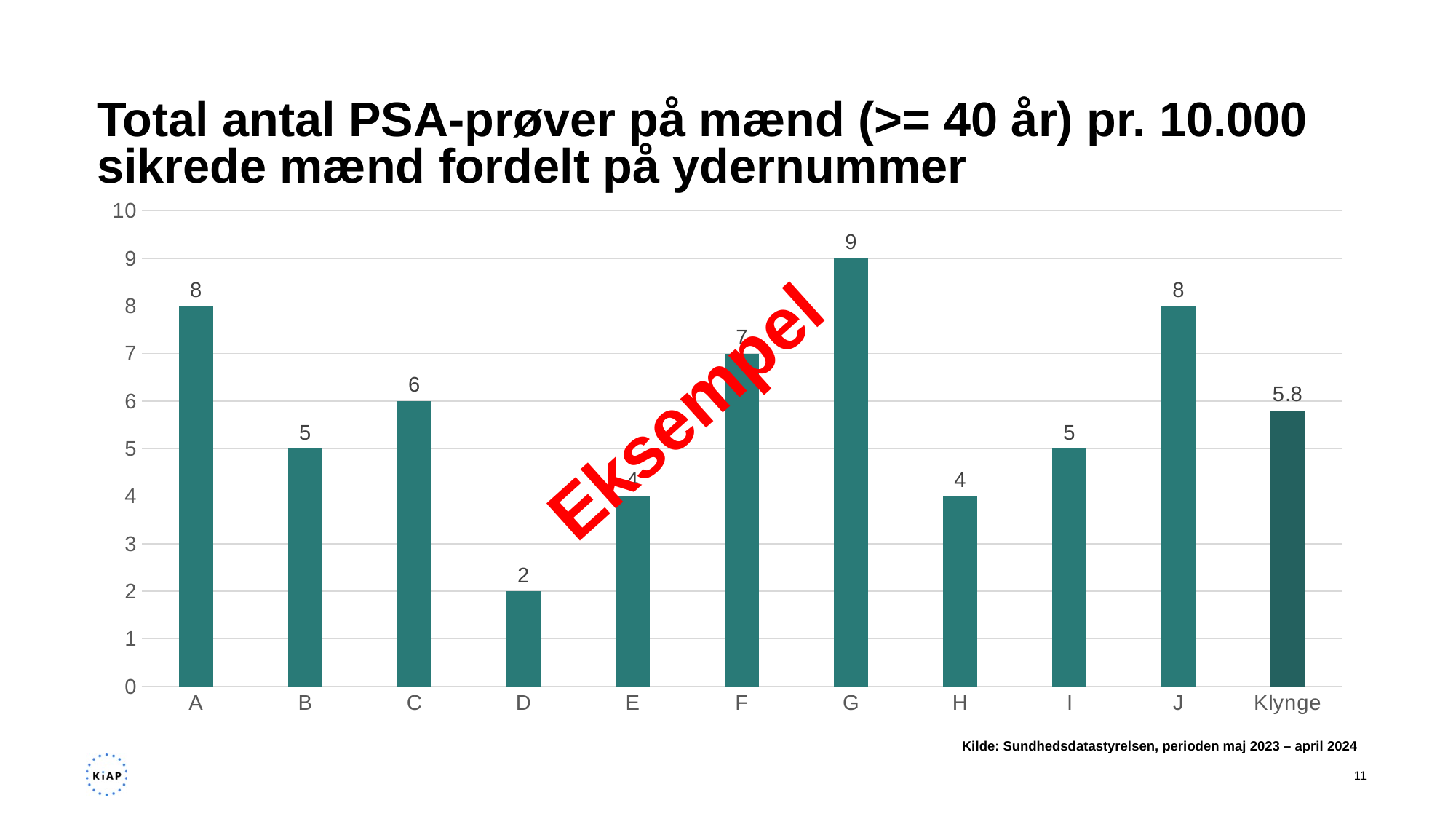
Which category has the highest value? G What is the difference between the values for G and Klynge? 3.2 Is the value for H greater or less than 5? less How many categories are shown on the x axis? 11 What is the source cited below the chart? Sundhedsdatastyrelsen, perioden maj 2023 – april 2024 What is the difference between the values for A and B? 3 What is the value for Klynge? 5.8 Which is larger, the value for C or the value for I? C What is the value for category G? 9 What is the value for category D? 2 Which category has the lowest value? D What kind of chart is shown on the slide? bar chart